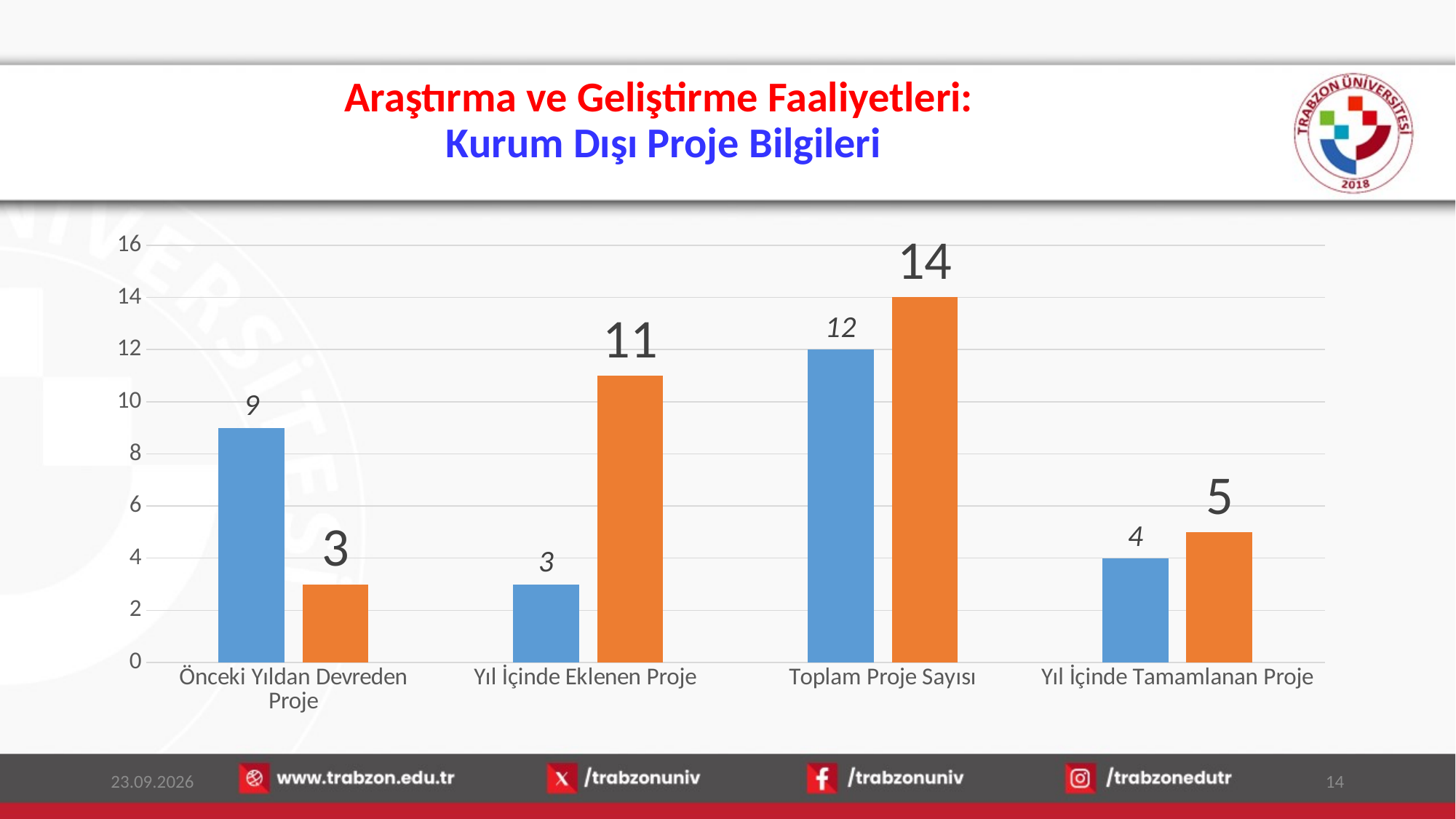
What is the value of the blue bar for Önceki Yıldan Devreden Proje? 9 What is the difference between the blue bar for Önceki Yıldan Devreden Proje and the orange bar for the same category? 6 For Toplam Proje Sayısı, which bar is larger, the blue or the orange? orange What is the value of the orange bar for Yıl İçinde Eklenen Proje? 11 What kind of chart is shown on the slide? bar chart Which category has the highest orange bar? Toplam Proje Sayısı Which category has the lowest blue bar? Yıl İçinde Eklenen Proje What is the difference between the orange and blue bars for Yıl İçinde Eklenen Proje? 8 What is the value of the orange bar for Yıl İçinde Tamamlanan Proje? 5 How many categories are shown on the x axis? 4 Is the orange bar for Toplam Proje Sayısı greater or less than 12? greater What is the value of the blue bar for Toplam Proje Sayısı? 12